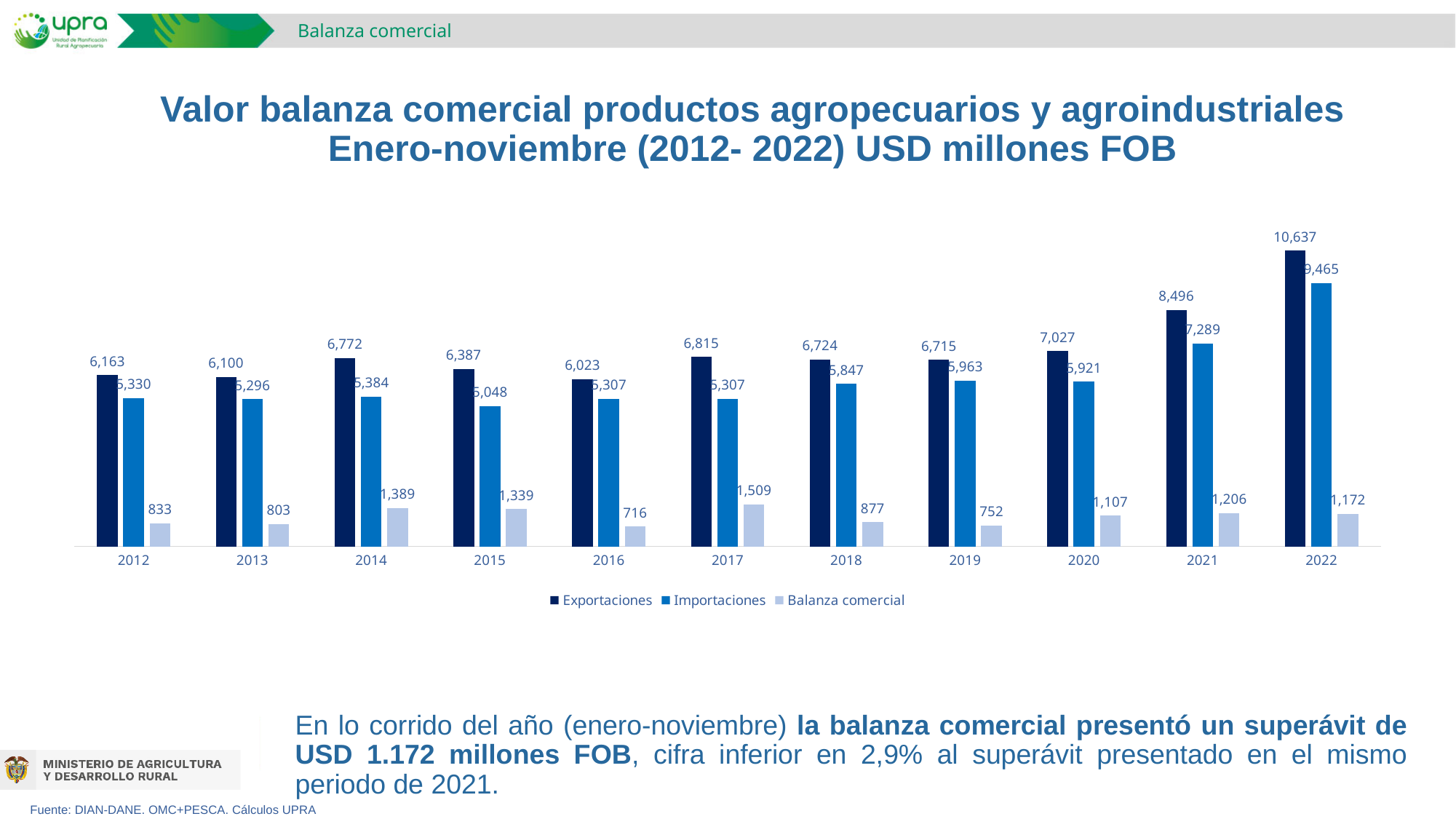
Which year has the highest Exportaciones value? 2022 How many years are shown on the x axis? 11 What is the value of Importaciones for 2021? 7,289 How many series does the legend list? 3 What kind of chart is shown on the slide? Bar chart Do the Exportaciones values rise or fall from 2019 to 2022? Rise What is the value of Balanza comercial for 2017? 1,509 What is the value of Exportaciones for 2022? 10,637 What is the difference between Exportaciones and Importaciones in 2022? 1,172 Which year has the lowest Exportaciones value? 2016 Which year has the lowest Balanza comercial value? 2016 Which is larger, the Balanza comercial for 2014 or for 2015? 2014